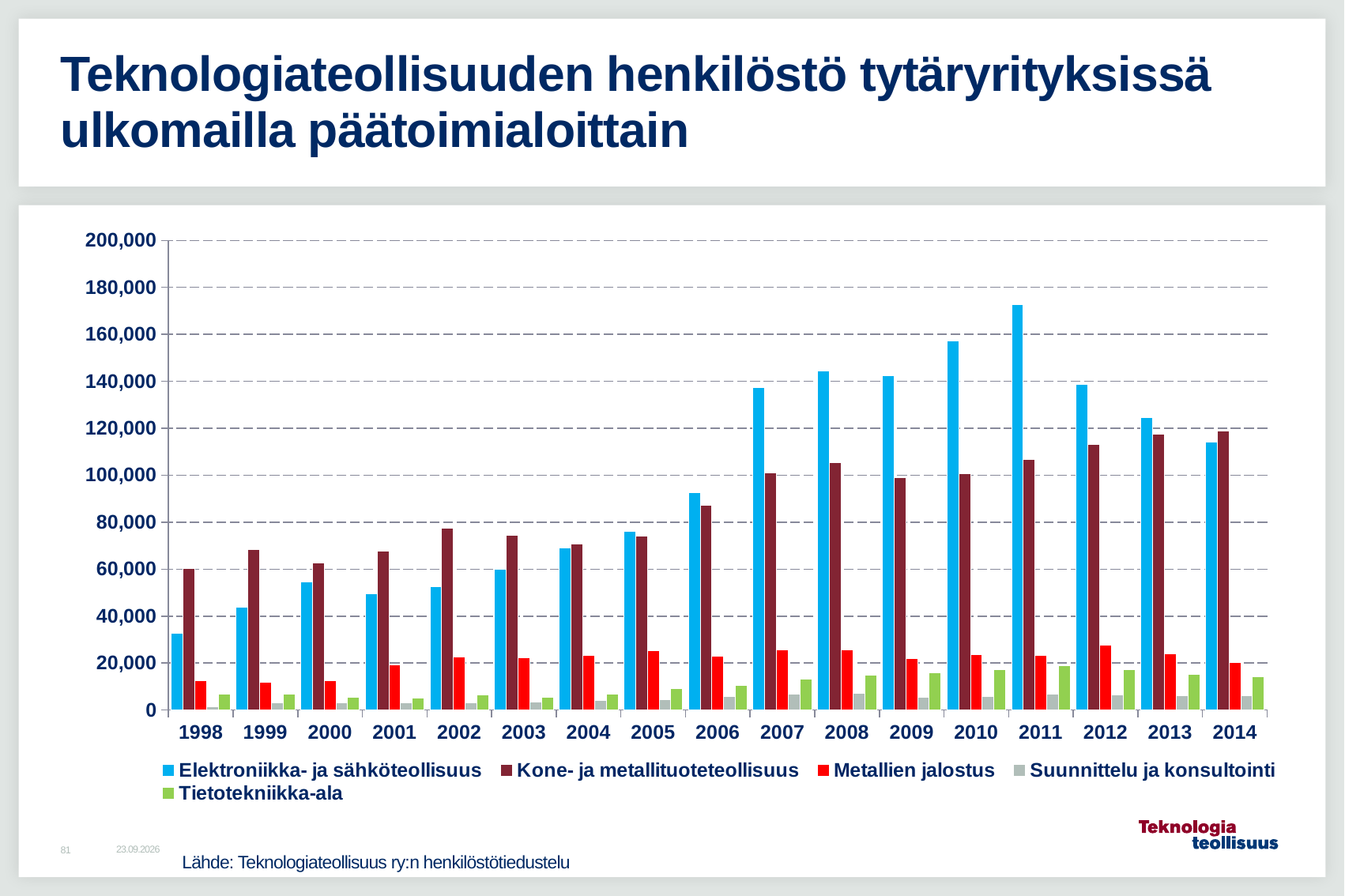
Is the value for Metallien jalostus in 2012 greater or less than 20,000? greater What kind of chart is shown on the slide? bar chart How many series does the legend list? 5 In which year is the value for Elektroniikka- ja sähköteollisuus highest? 2011 In 1998, which is larger: Elektroniikka- ja sähköteollisuus or Kone- ja metallituoteteollisuus? Kone- ja metallituoteteollisuus How many years are shown on the x axis? 17 Is the value for Elektroniikka- ja sähköteollisuus in 1998 greater or less than 40,000? less Is the value for Kone- ja metallituoteteollisuus in 2014 greater or less than 100,000? greater Does the value for Elektroniikka- ja sähköteollisuus rise or fall from 2011 to 2014? fall In 2007, which is larger: Elektroniikka- ja sähköteollisuus or Kone- ja metallituoteteollisuus? Elektroniikka- ja sähköteollisuus In which year is the value for Elektroniikka- ja sähköteollisuus lowest? 1998